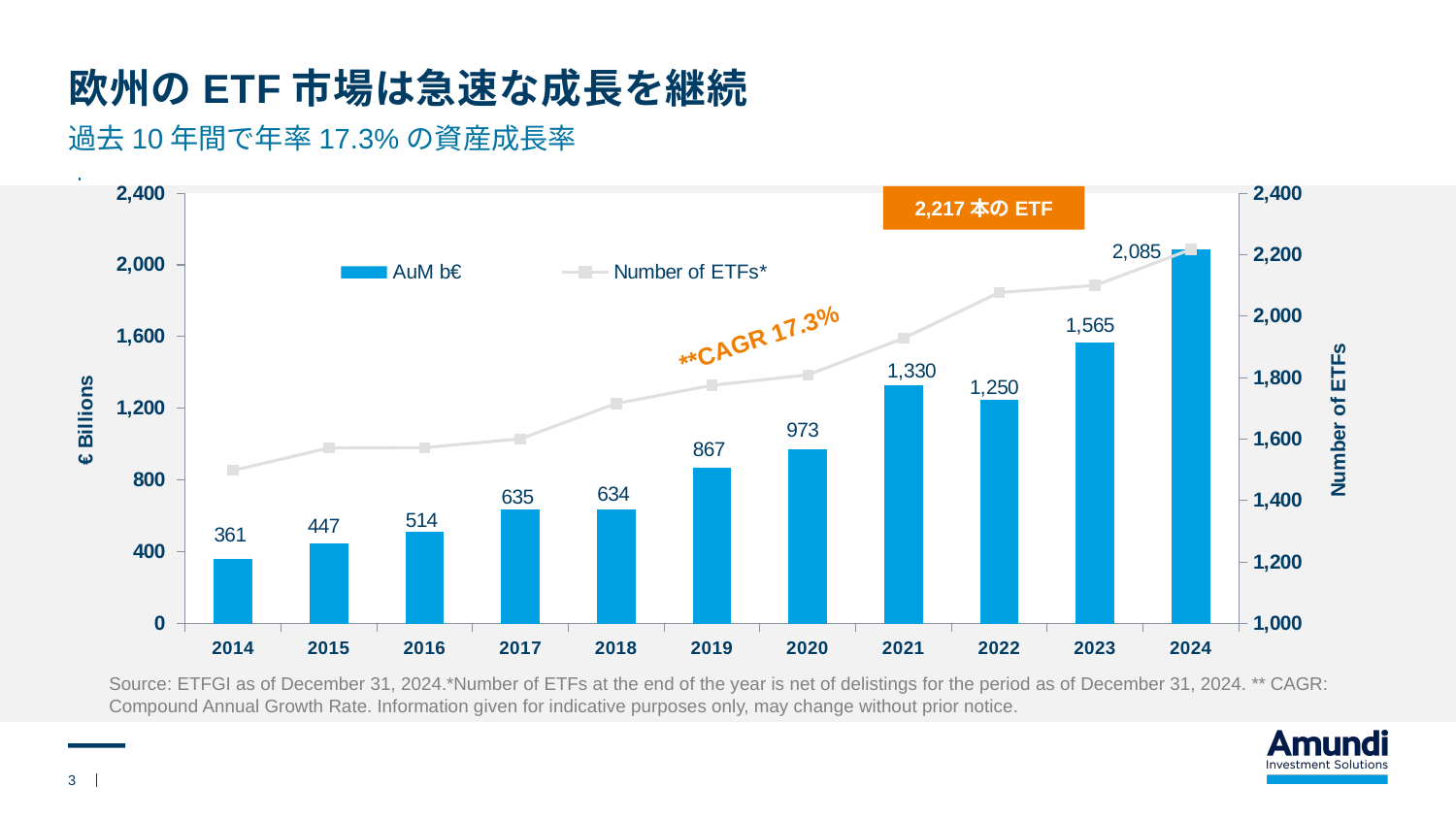
What is the difference in AuM b€ between 2021 and 2022? 80 What is the difference in AuM b€ between 2024 and 2023? 520 Is the Number of ETFs for 2021 greater or less than 1,800? greater What is the AuM b€ value for 2024? 2,085 Which year has the highest AuM b€? 2024 Is the Number of ETFs for 2014 greater or less than 1,600? less What is the AuM b€ value for 2019? 867 How many years are shown on the x axis? 11 How many series does the legend list? 2 Which year has the lowest AuM b€? 2014 How many ETFs are shown for 2024 in the callout? 2,217 Which year has the larger AuM b€, 2021 or 2022? 2021